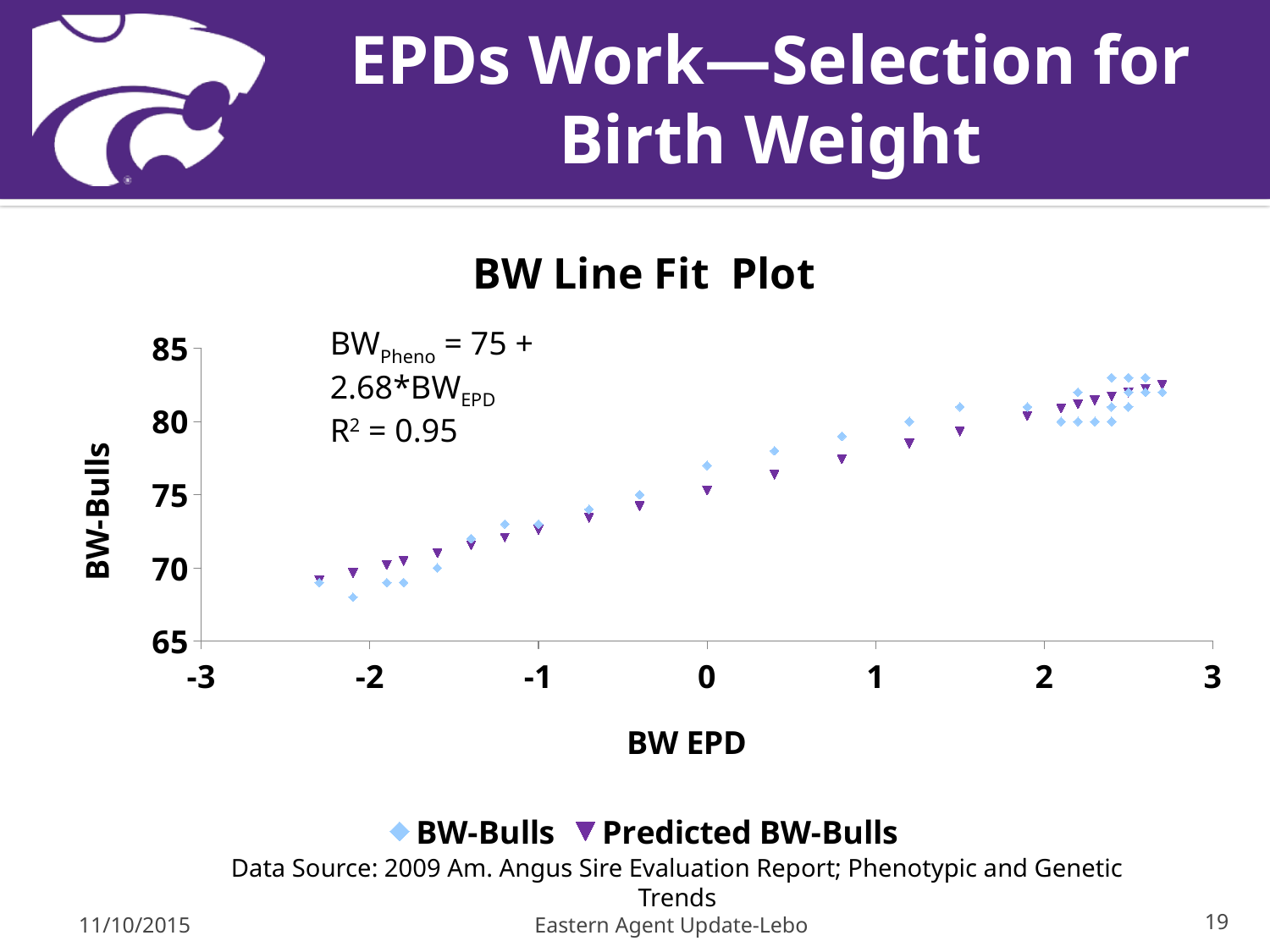
What is the R-squared value printed on the chart? 0.95 What are the two series named in the legend? BW-Bulls and Predicted BW-Bulls How many series does the legend list? 2 Is the Predicted BW-Bulls value at a BW EPD of about -2.3 greater or less than 70? less Is the lowest BW-Bulls value, near a BW EPD of -2.1, greater or less than 70? less What is the title of the chart? BW Line Fit Plot What is the slope coefficient in the fitted equation printed on the chart? 2.68 Do the BW-Bulls values rise or fall as BW EPD increases along the x axis? Rise What kind of chart is shown on the slide? Scatter plot Is the BW-Bulls value at a BW EPD of 0 greater or less than 75? greater